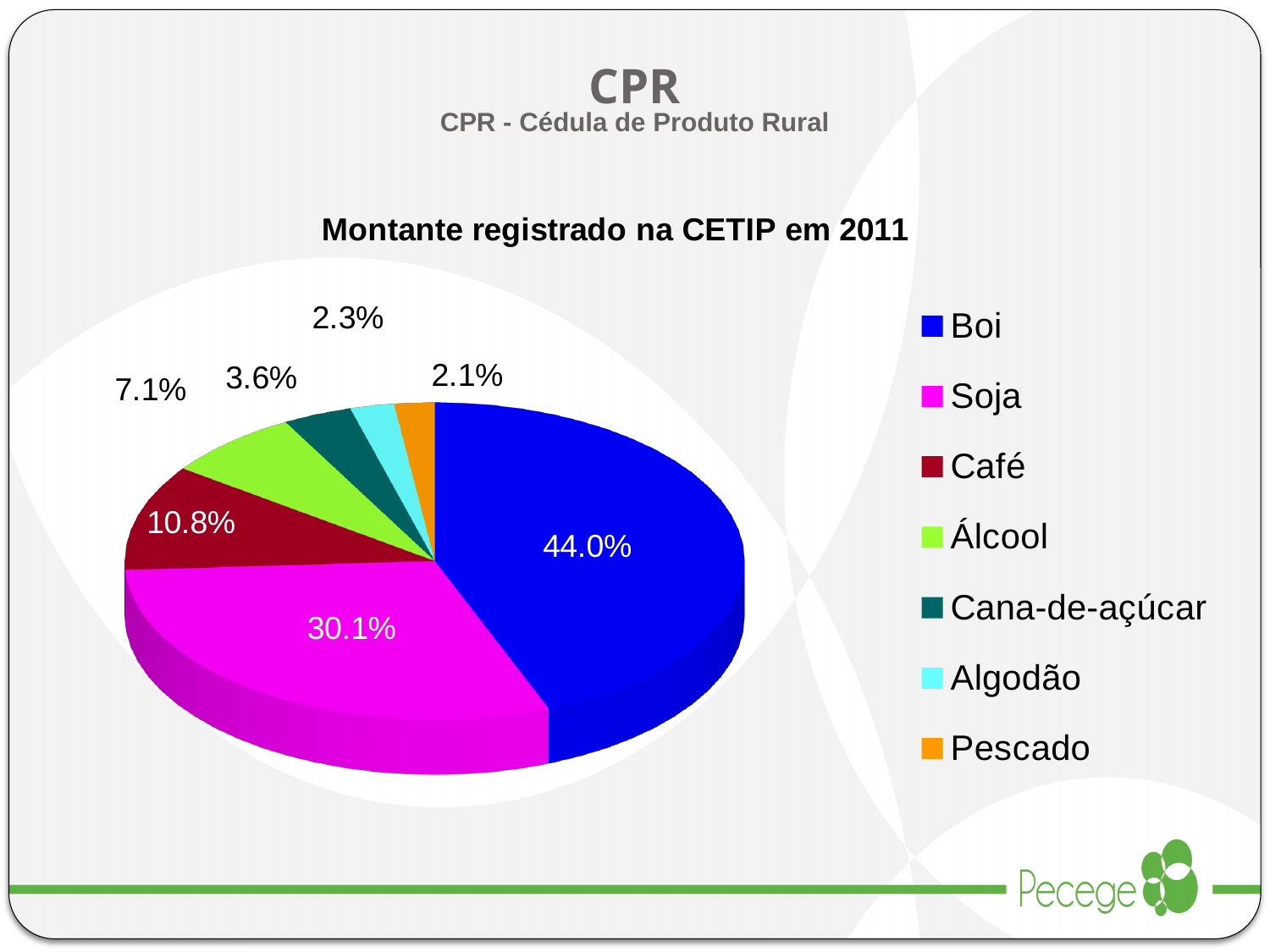
What is the value shown for Café? 10.8% What is the difference between the shares of Boi and Soja? 13.9% What is the value shown for Álcool? 7.1% What type of chart is shown on the slide? Pie chart How many categories does the legend list? 7 Which category has the largest share of the pie? Boi What is the title of the chart? Montante registrado na CETIP em 2011 What share of the pie does Boi represent? 44.0% Which is larger, the share for Algodão or the share for Pescado? Algodão Which category has the smallest share of the pie? Pescado What is the value shown for Cana-de-açúcar? 3.6% What share of the pie does Soja represent? 30.1%